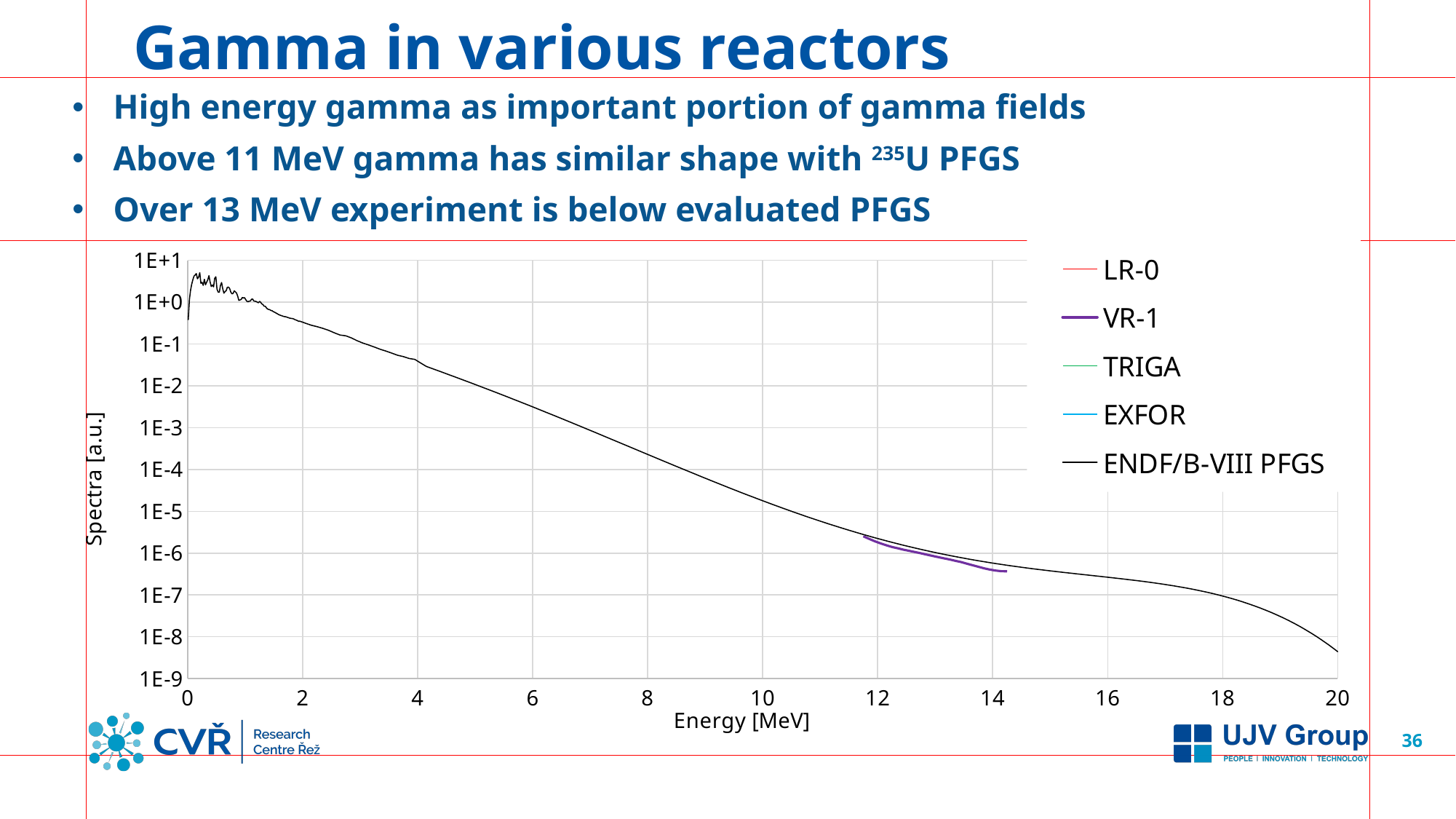
Is the value of the ENDF/B-VIII PFGS curve at 20 MeV greater or less than 1E-8? less What kind of chart is shown on the slide? line chart What is the label of the x axis? Energy [MeV] Is the value of the ENDF/B-VIII PFGS curve at 4 MeV greater or less than 1E-1? less Does the ENDF/B-VIII PFGS curve rise or fall as energy increases from 2 MeV to 20 MeV? fall How many series does the legend list? 5 Is the value of the VR-1 curve at 14 MeV greater or less than 1E-6? less At 13 MeV, which is larger: the VR-1 curve or the ENDF/B-VIII PFGS curve? ENDF/B-VIII PFGS What is the label of the y axis? Spectra [a.u.] What is the highest energy value shown on the x axis? 20